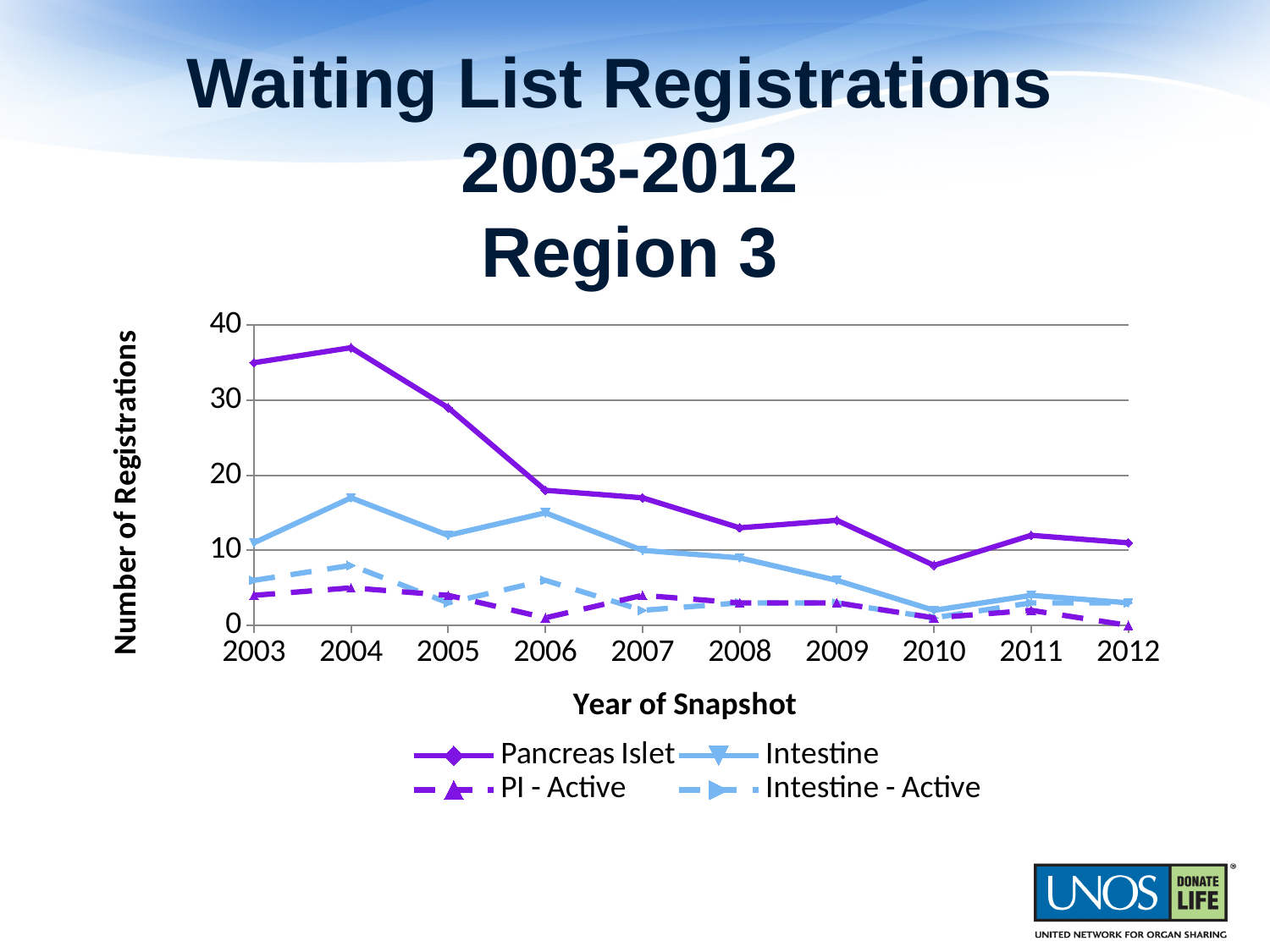
Is the Pancreas Islet value for 2004 greater or less than 30? greater Is the Intestine value for 2004 greater or less than 10? greater Is the Intestine value for 2010 greater or less than 10? less What is the label of the y axis? Number of Registrations How many series does the legend list? 4 What kind of chart is shown on the slide? line chart In which year is the Pancreas Islet series lowest? 2010 Does the Pancreas Islet series generally rise or fall from 2003 to 2012? fall In which year is the Pancreas Islet series highest? 2004 Which is larger in 2003, Pancreas Islet or Intestine? Pancreas Islet How many years are shown on the x axis? 10